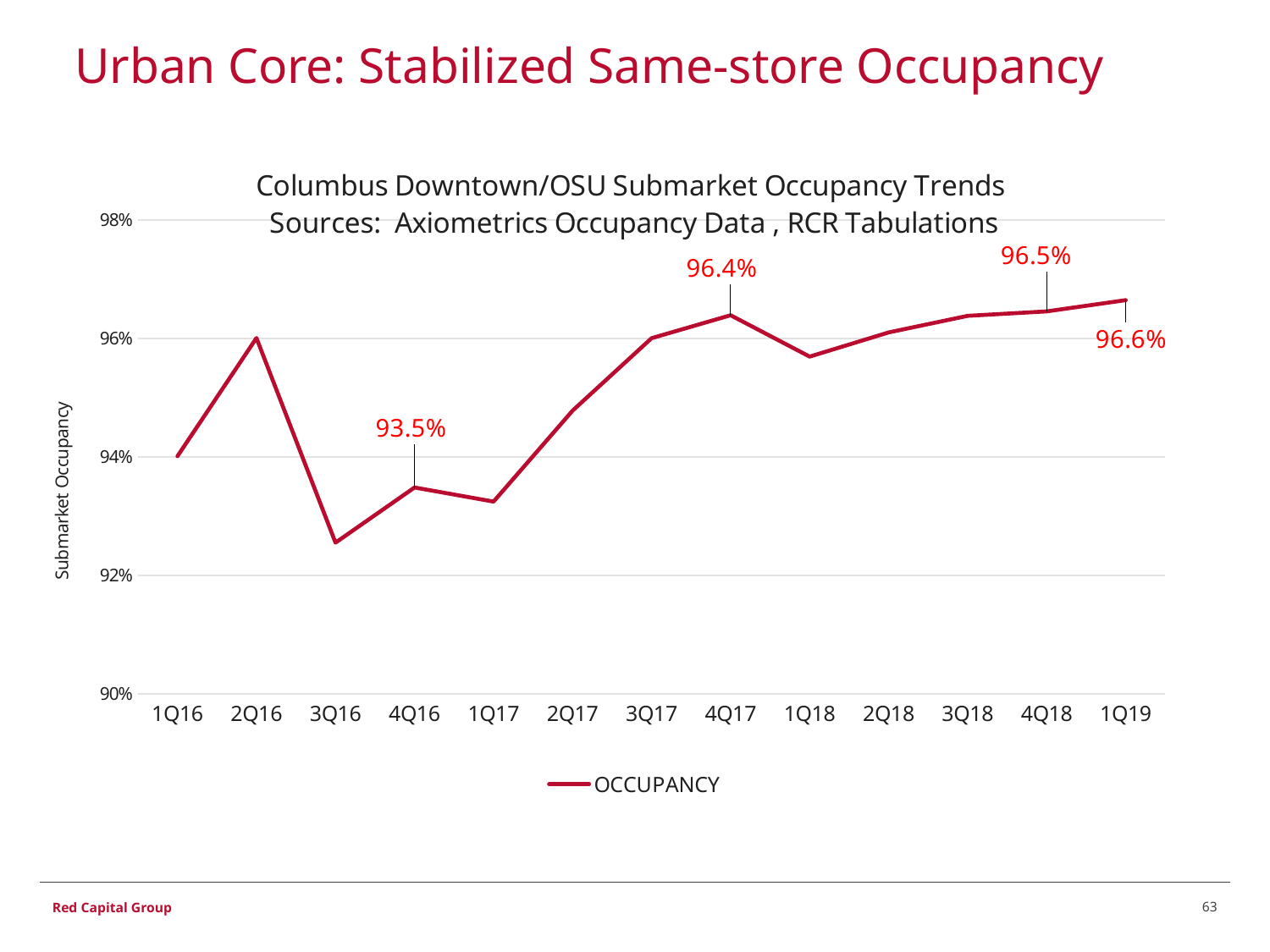
What is the occupancy value shown for 1Q19? 96.6% Which quarter has the lowest occupancy on the chart? 3Q16 Is the occupancy value for 3Q16 greater or less than 94%? less Which quarter has the highest occupancy on the chart? 1Q19 Which is larger, the occupancy in 4Q18 or in 4Q17? 4Q18 Is the occupancy value for 1Q18 greater or less than 94%? greater What is the difference between the occupancy in 1Q19 and in 4Q16? 3.1 percentage points What is the name of the series listed in the legend? OCCUPANCY What is the occupancy value shown for 4Q16? 93.5% What kind of chart is shown on the slide? Line chart How many quarters are plotted on the x axis? 13 What is the occupancy value shown for 4Q17? 96.4%